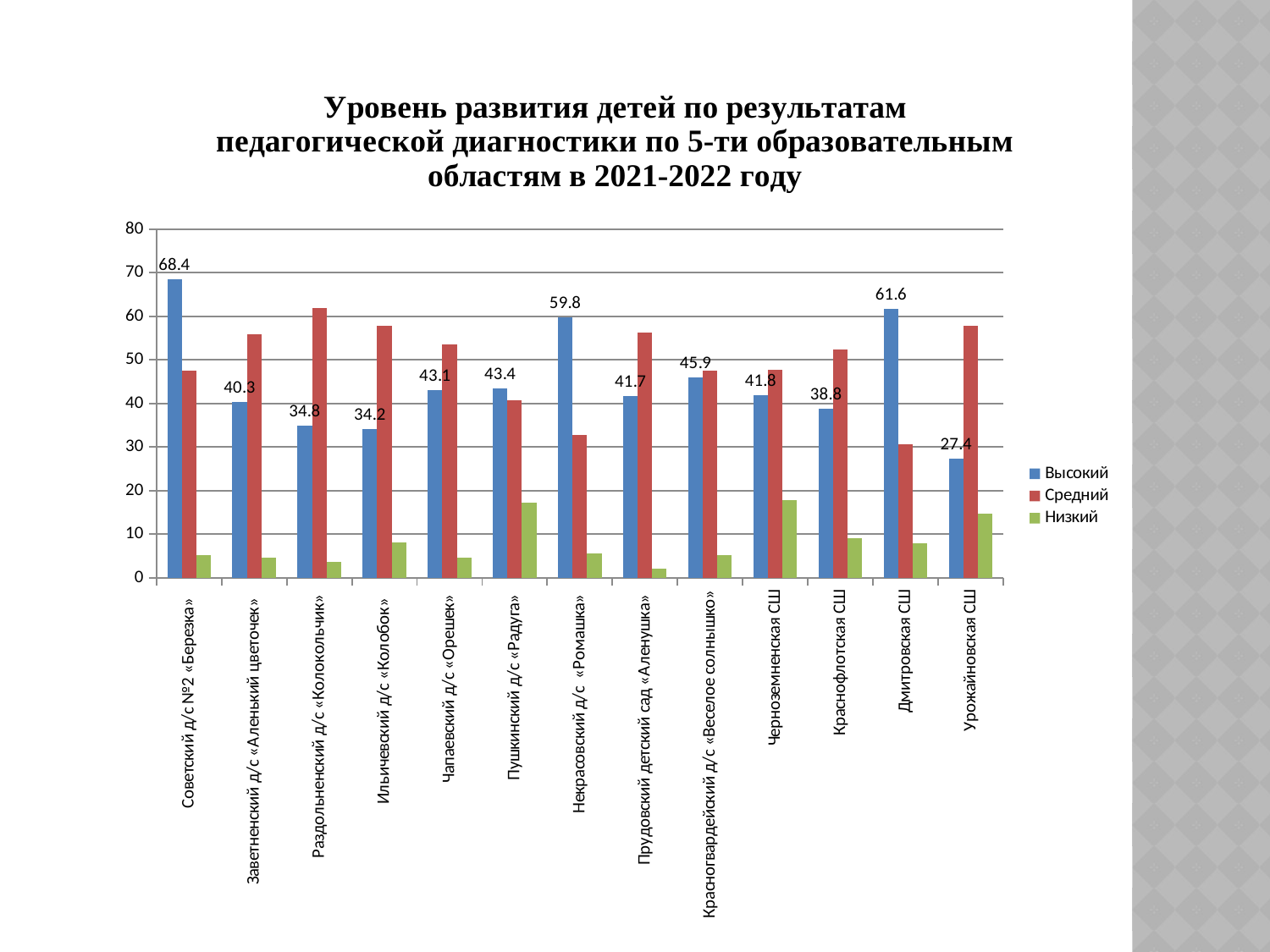
What is the Высокий value for Урожайновская СШ? 27.4 Which institution has the lowest Высокий value? Урожайновская СШ How many institutions (categories) are shown on the x axis? 13 What is the Высокий value for Советский д/с №2 «Березка»? 68.4 How many series does the legend list? 3 Which has a larger Высокий value, Чапаевский д/с «Орешек» or Раздольненский д/с «Колокольчик»? Чапаевский д/с «Орешек» Which series is shown in green in the legend? Низкий What is the difference between the Высокий values for Дмитровская СШ and Краснофлотская СШ? 22.8 Which institution has the highest Высокий value? Советский д/с №2 «Березка» What is the Высокий value for Некрасовский д/с «Ромашка»? 59.8 What type of chart is shown on the slide? bar chart Is the Средний value for Раздольненский д/с «Колокольчик» greater or less than 50? greater